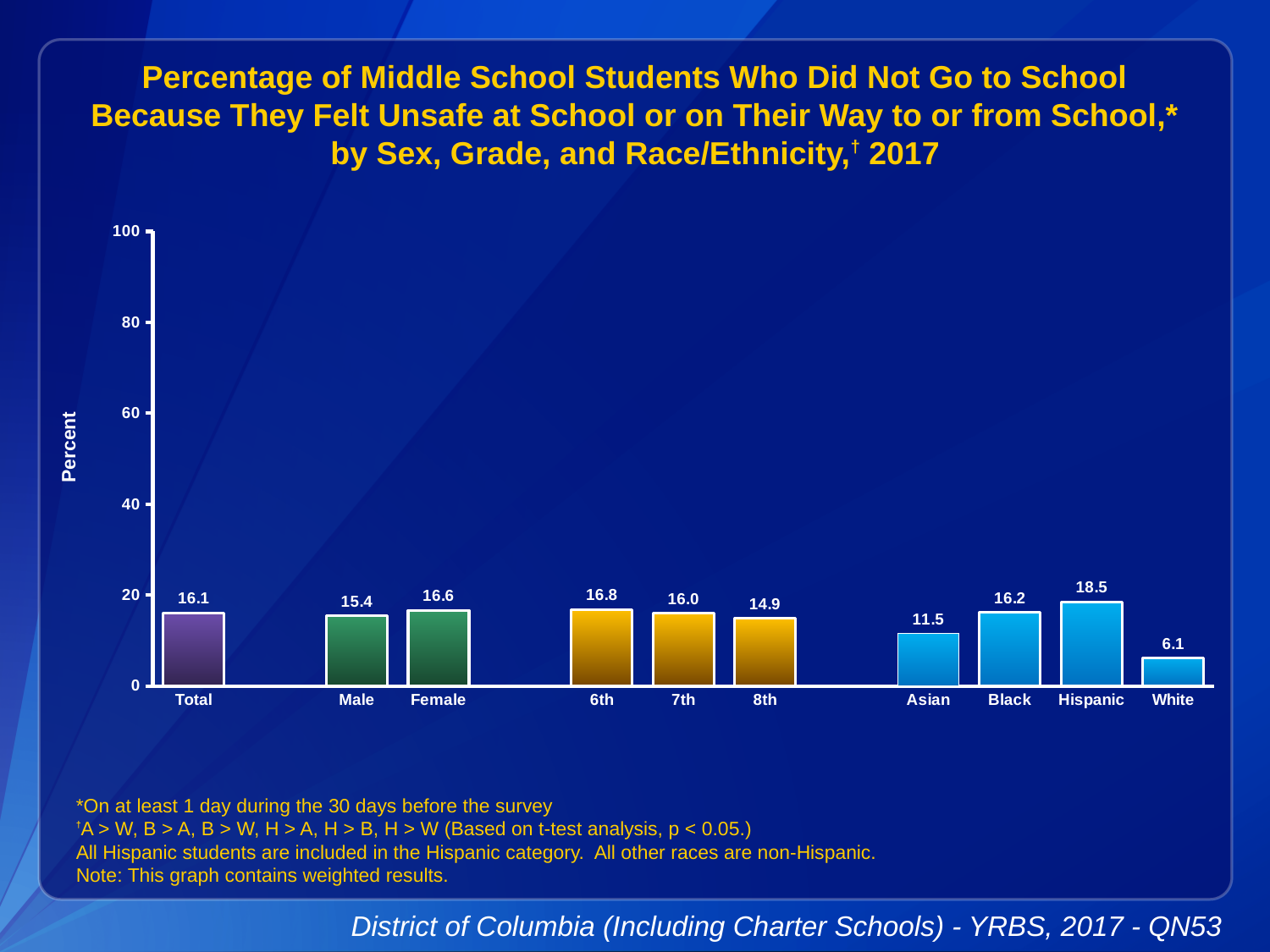
Which is larger, the value for 6th or the value for 8th? 6th What is the value for Female? 16.6 What is the label of the y axis? Percent Which category has the lowest value? White What kind of chart is this? bar chart How many categories are shown on the x axis? 10 What is the difference between the values for Hispanic and White? 12.4 What is the value for Total? 16.1 Is the value for Black greater or less than 20? less What is the difference between the values for Female and Male? 1.2 What is the value for Asian? 11.5 Which category has the highest value? Hispanic